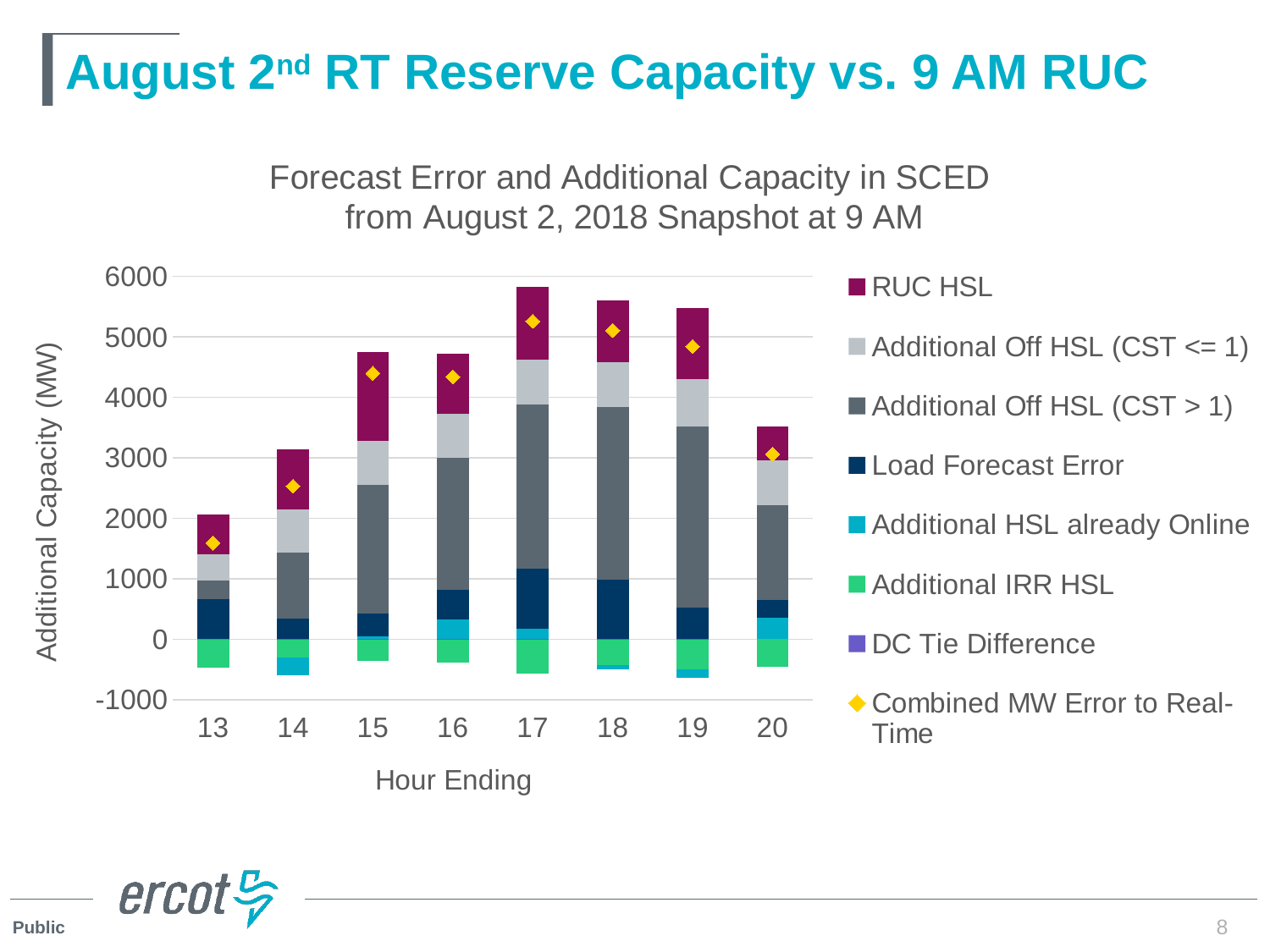
Is the Combined MW Error to Real-Time value for hour ending 13 greater or less than 2000? less Which stacked bar reaches higher, hour ending 15 or hour ending 14? 15 Is the top of the stacked bar for hour ending 20 greater or less than 3000? greater Is the Combined MW Error to Real-Time value for hour ending 17 greater or less than 5000? greater How many hour-ending categories are shown on the x axis? 8 What kind of chart is shown on the slide? bar chart Which hour ending has the lowest Combined MW Error to Real-Time marker? 13 What is the label on the x axis of the chart? Hour Ending How many series does the legend list? 8 Does the Combined MW Error to Real-Time marker rise or fall from hour ending 13 to hour ending 17? rise Which hour ending has the shortest stacked bar overall? 13